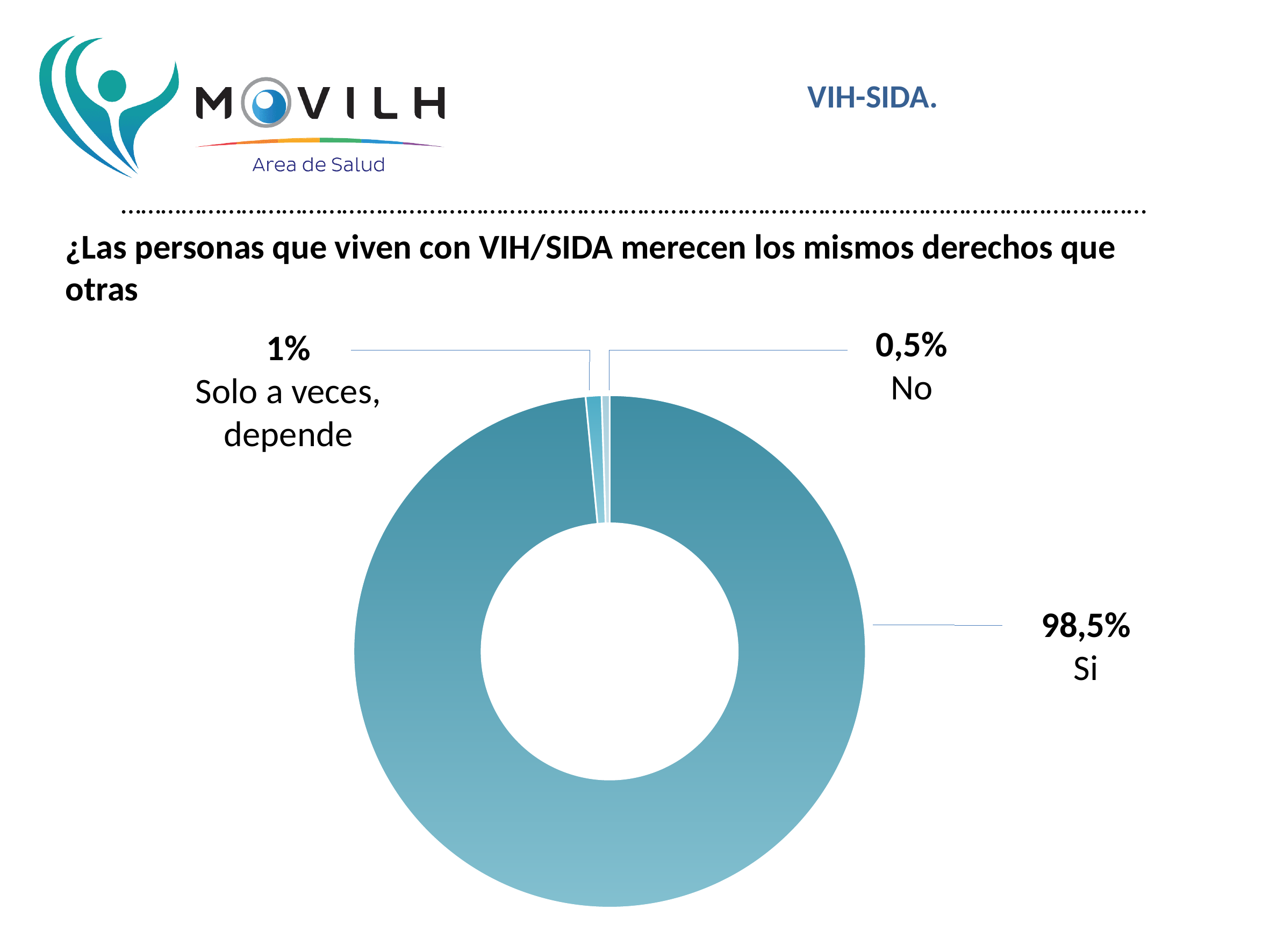
What percentage of respondents answered "No"? 0,5% What percentage of respondents answered "Si"? 98,5% How many response categories are shown in the chart? 3 What question does the chart on the slide answer? ¿Las personas que viven con VIH/SIDA merecen los mismos derechos que otras Which response has the smallest share of the chart? No What percentage of respondents answered "Solo a veces, depende"? 1% Which is larger, the share for "No" or the share for "Solo a veces, depende"? Solo a veces, depende What is the combined share of "No" and "Solo a veces, depende"? 1,5% What kind of chart is shown on the slide? Pie chart (doughnut) What is the difference in percentage points between "Si" and "Solo a veces, depende"? 97,5% What is the difference in percentage points between "Solo a veces, depende" and "No"? 0,5% Which response has the largest share of the chart? Si